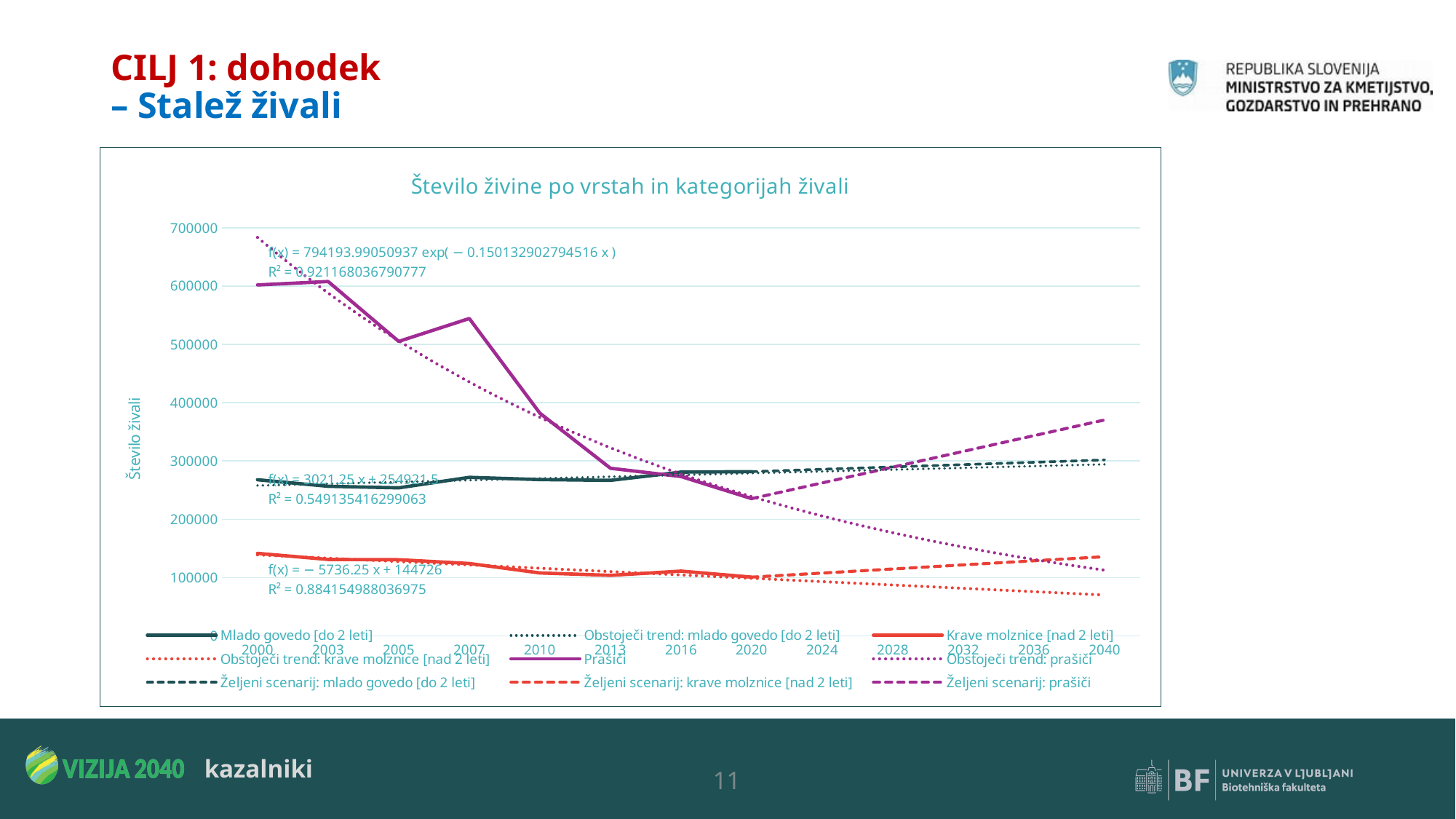
What type of chart is shown on the slide? line chart What is the title of the chart? Število živine po vrstah in kategorijah živali Is the value for Željeni scenarij: prašiči in 2040 greater or less than 300000? greater Which series has the highest value in 2000? Prašiči Is the value for Mlado govedo [do 2 leti] in 2000 greater or less than 300000? less In 2020, which is larger: Mlado govedo [do 2 leti] or Prašiči? Mlado govedo [do 2 leti] How many series does the chart legend list? 9 Does the Prašiči series rise or fall between 2000 and 2020? fall Is the value for Prašiči in 2000 greater or less than 500000? greater How many year labels are shown on the x axis? 13 Which series has the lowest value in 2000? Krave molznice [nad 2 leti] What is the label of the y axis? Število živali